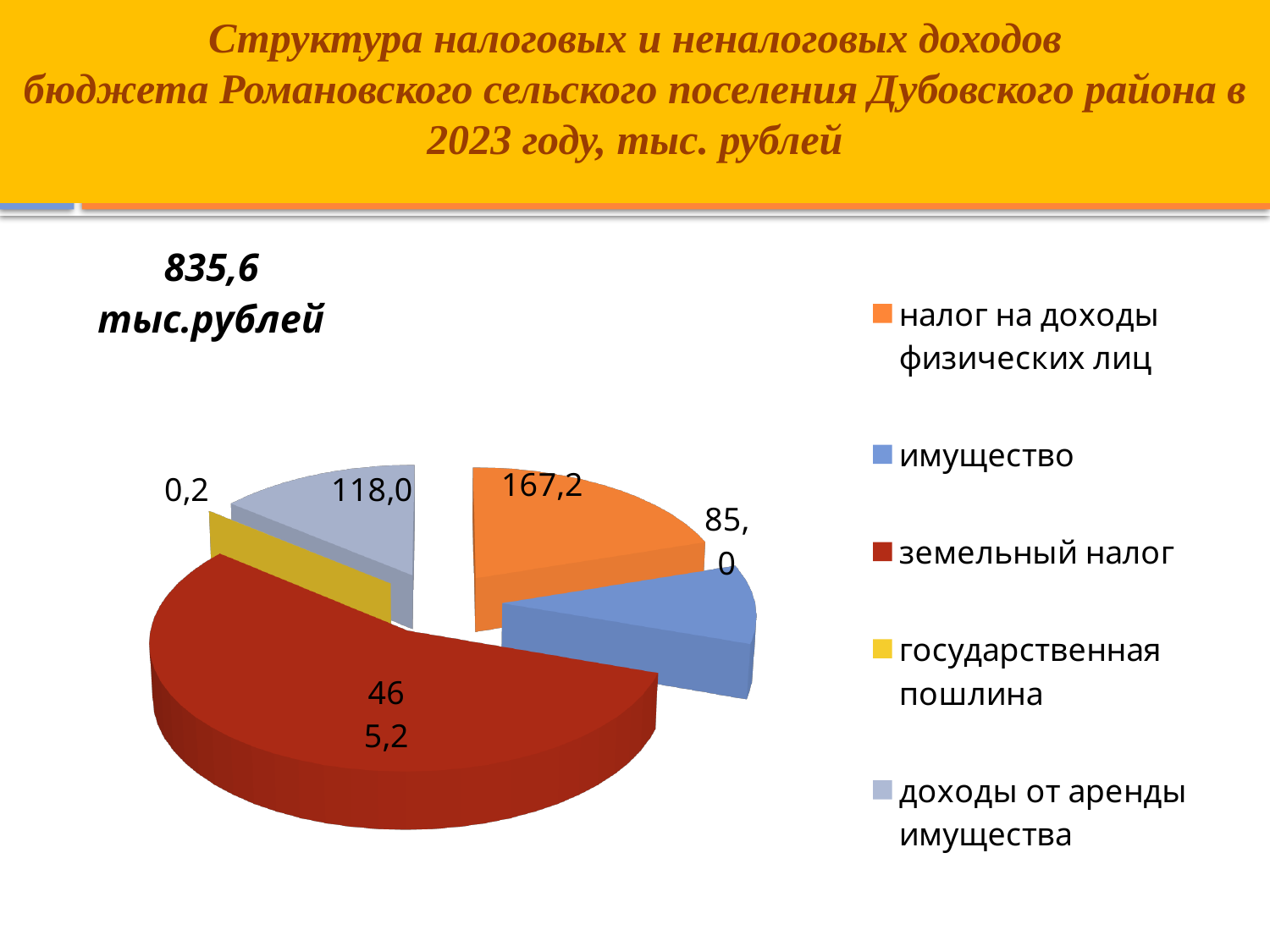
What is the value for налог на доходы физических лиц? 167,2 How many categories does the pie chart have? 5 Which is larger, доходы от аренды имущества or имущество? доходы от аренды имущества Which category has the smallest slice of the pie? государственная пошлина Which category has the largest slice of the pie? земельный налог What is the value for имущество? 85,0 What type of chart is shown on the slide? pie chart What is the value for земельный налог? 465,2 What is the value for доходы от аренды имущества? 118,0 What total amount is shown on the slide for all revenues? 835,6 тыс.рублей What is the value for государственная пошлина? 0,2 What is the difference between налог на доходы физических лиц and имущество? 82,2